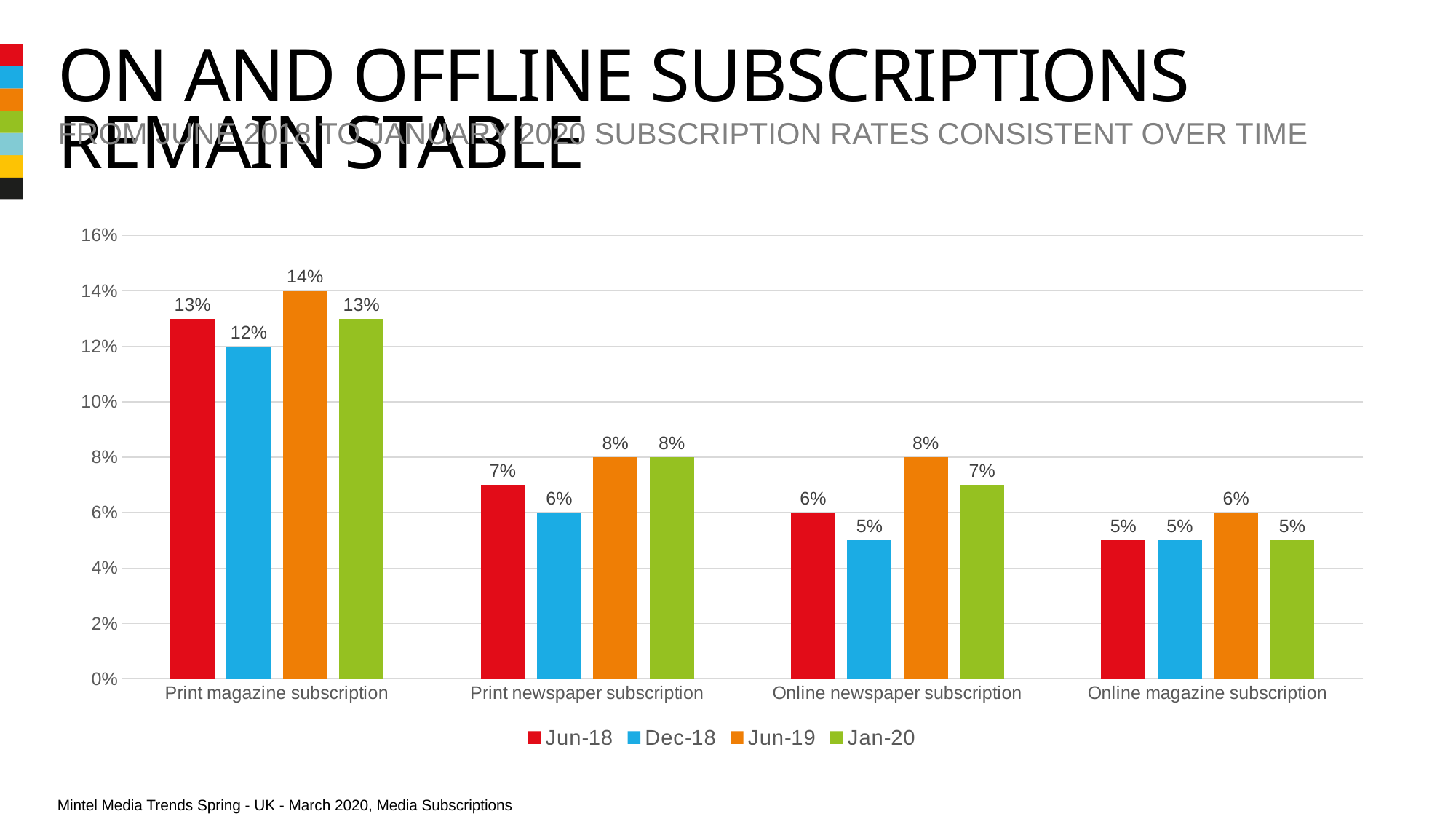
What kind of chart is shown on the slide? Bar chart What is the difference between the Jun-19 and Dec-18 values for Print magazine subscription? 2% Is the Jun-18 value for Print magazine subscription greater or less than 10%? greater Which category has the highest value in the Jun-18 series? Print magazine subscription Which series is shown in orange in the legend? Jun-19 How many categories are shown on the x axis? 4 What is the value for Online newspaper subscription in Dec-18? 5% Which is larger: the Jun-19 value for Online newspaper subscription or the Jun-19 value for Online magazine subscription? Online newspaper subscription What is the value for Print newspaper subscription in Jan-20? 8% How many series does the legend list? 4 What is the value for Print magazine subscription in Jun-19? 14% Which category has the lowest value in the Jan-20 series? Online magazine subscription